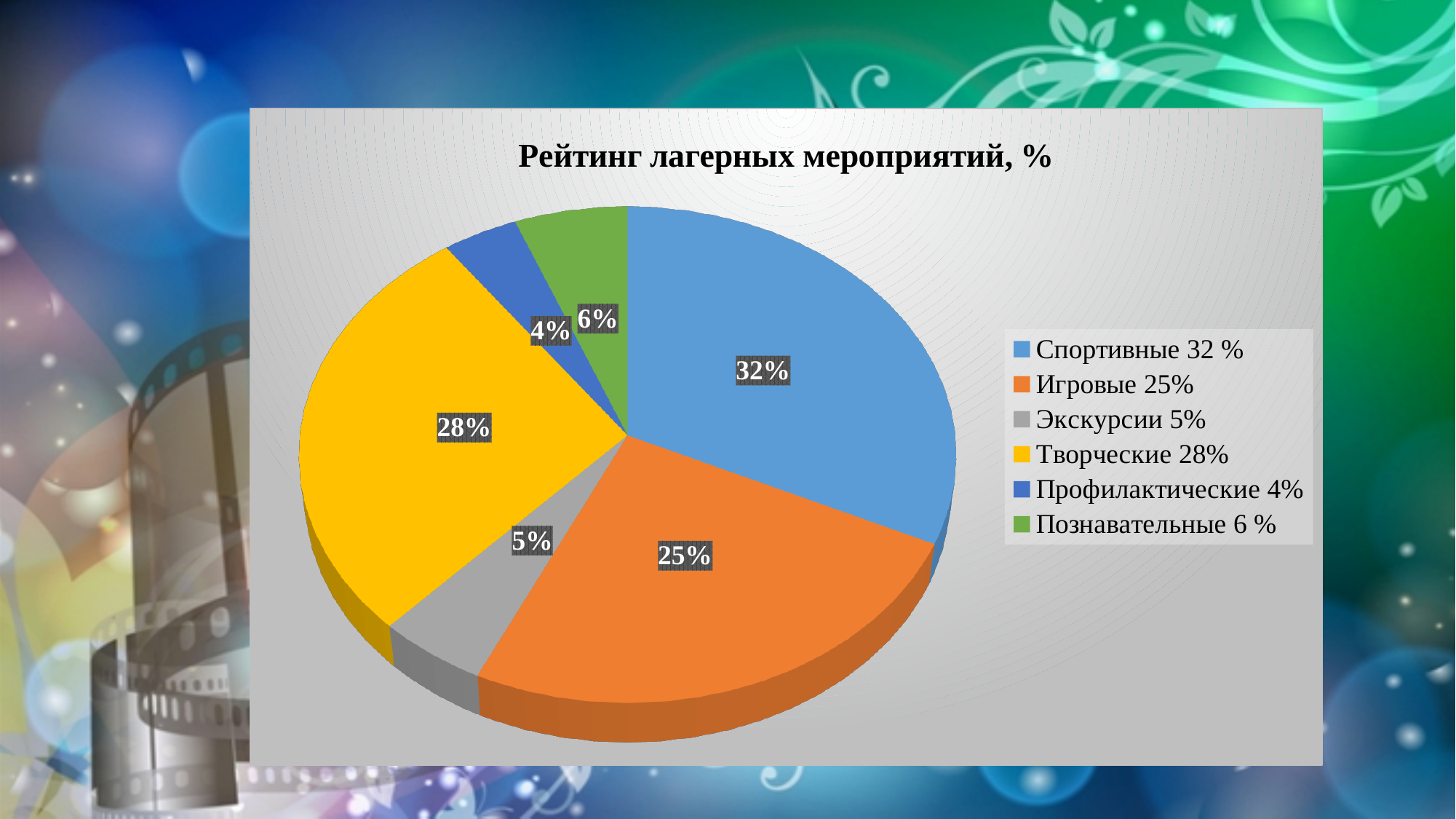
Which is larger, the share of Творческие or the share of Игровые? Творческие What kind of chart is shown on the slide? Pie chart Which category has the smallest share of the pie? Профилактические How many categories does the pie chart have? 6 Which category has the largest share of the pie? Спортивные What is the difference between the shares of Спортивные and Игровые? 7% What is the title of the chart? Рейтинг лагерных мероприятий, % What percentage is shown for Экскурсии? 5% What percentage is shown for Творческие? 28% What colour is the slice for Познавательные? Green What is the difference between the shares of Познавательные and Профилактические? 2% What percentage is shown for Спортивные? 32%